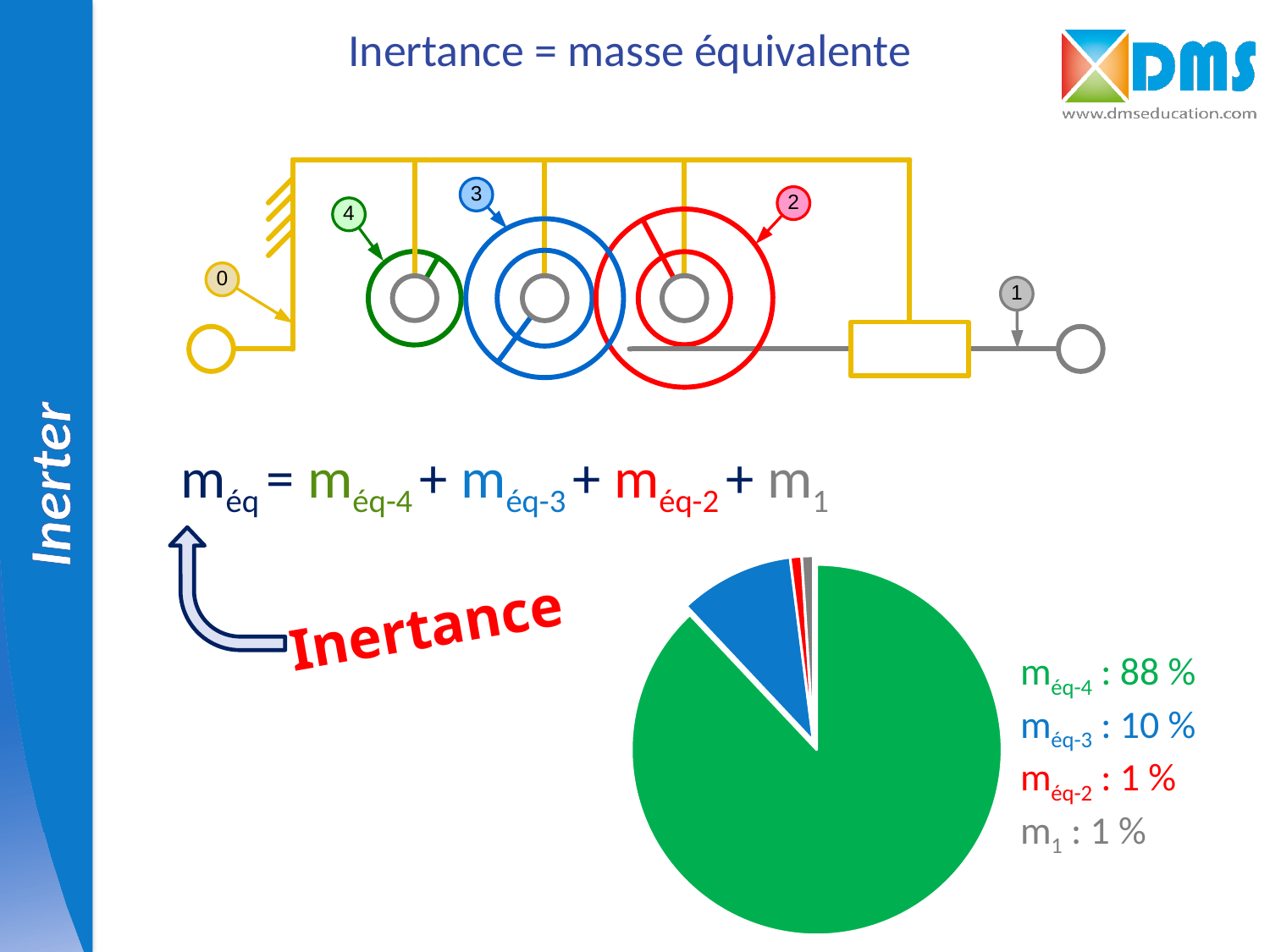
What type of chart is shown on the slide? pie chart What colour is the slice for m_éq-4 in the pie chart? green What is the difference between the shares of m_éq-4 and m_éq-3? 78 % How many slices does the pie chart have? 4 What is the value shown for m_1? 1 % What share of the pie does m_éq-4 represent? 88 % What is the value shown for m_éq-2? 1 % Which component has the largest share of the pie? m_éq-4 What is the difference between the shares of m_éq-3 and m_1? 9 % What share of the pie does m_éq-3 represent? 10 % What colour is the slice for m_éq-3 in the pie chart? blue Which is larger, the share of m_éq-3 or the share of m_éq-2? m_éq-3